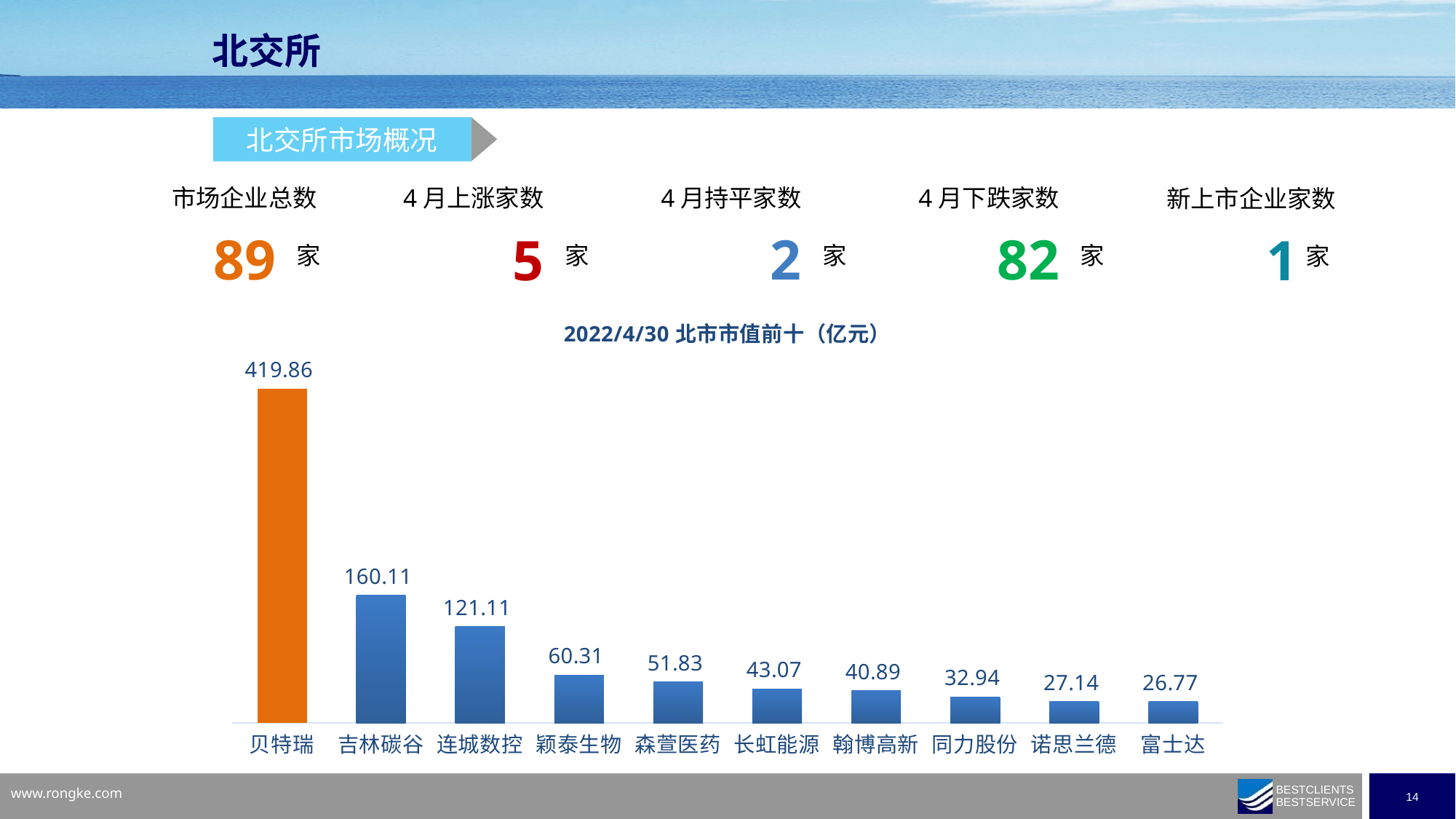
What is the market value shown for 吉林碳谷? 160.11 What type of chart is used to show the top ten market values? Bar chart What is the difference between the market values of 吉林碳谷 and 连城数控? 49.00 What is the market value shown for 同力股份? 32.94 Which company has the highest market value in the chart? 贝特瑞 What is the market value shown for 贝特瑞? 419.86 Which company has the lowest market value in the chart? 富士达 How many companies are shown in the chart? 10 Which has a larger market value, 森萱医药 or 长虹能源? 森萱医药 What is the market value shown for 颖泰生物? 60.31 What is the title of the chart? 2022/4/30 北市市值前十（亿元） What is the difference between the market values of 贝特瑞 and 吉林碳谷? 259.75